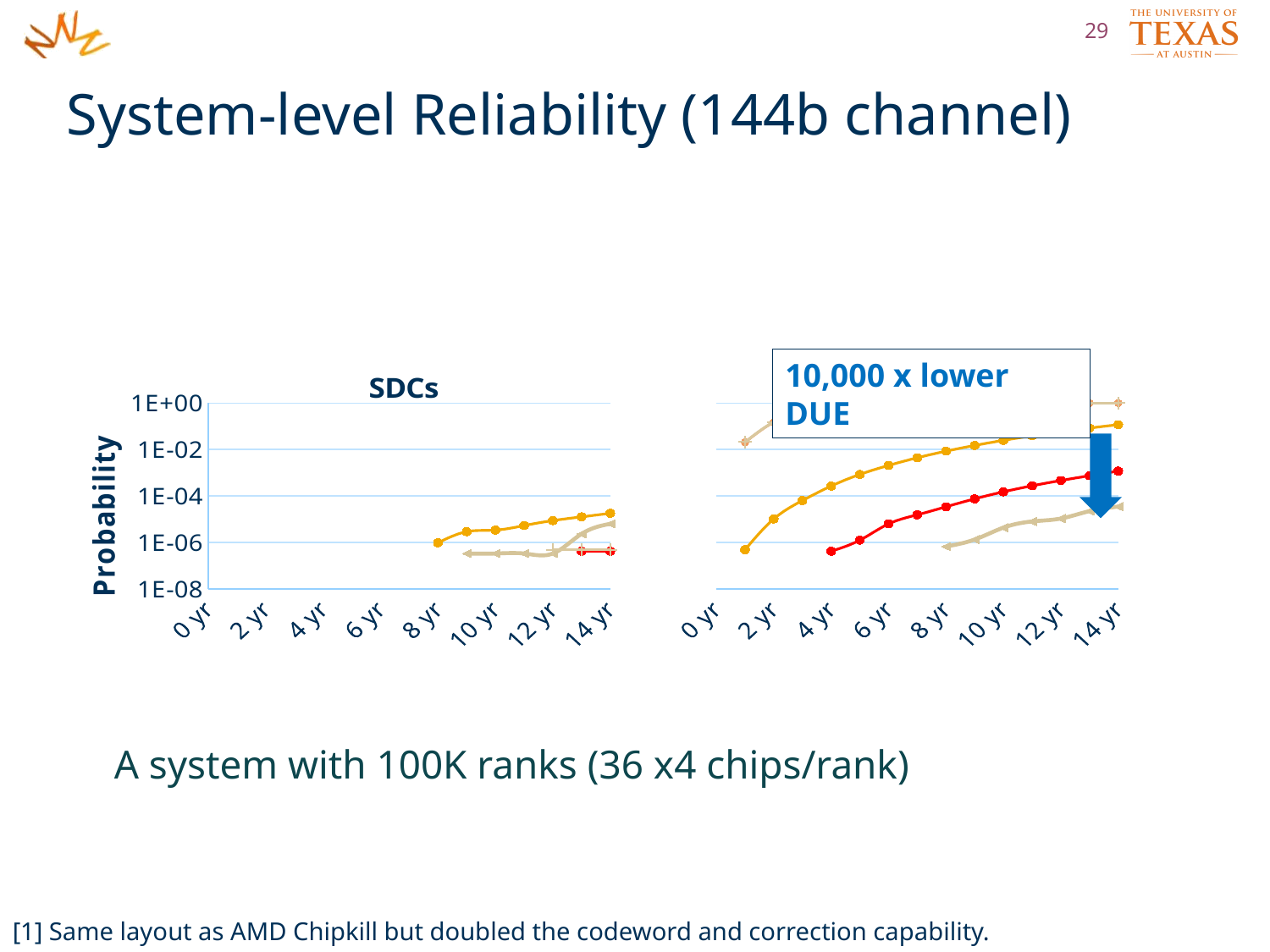
In the right chart, does the orange line rise or fall as the years increase? rise In the right chart, is the value of the red line at 14 yr greater or less than 1E-02? less In the left "SDCs" chart, is the value of the orange line at 14 yr greater or less than 1E-04? less In the right chart at 14 yr, which line has the higher value, the orange line or the red line? orange line What is the y-axis label shared by the charts? Probability What is the title of the left chart? SDCs What kind of chart is the left chart titled "SDCs"? line chart What is the lowest value shown on the y axis of the charts? 1E-08 In the left "SDCs" chart, does the orange line rise or fall from 8 yr to 14 yr? rise How many year labels are shown on the x axis of the left "SDCs" chart? 8 In the right chart, is the value of the red line at 14 yr greater or less than 1E-04? greater